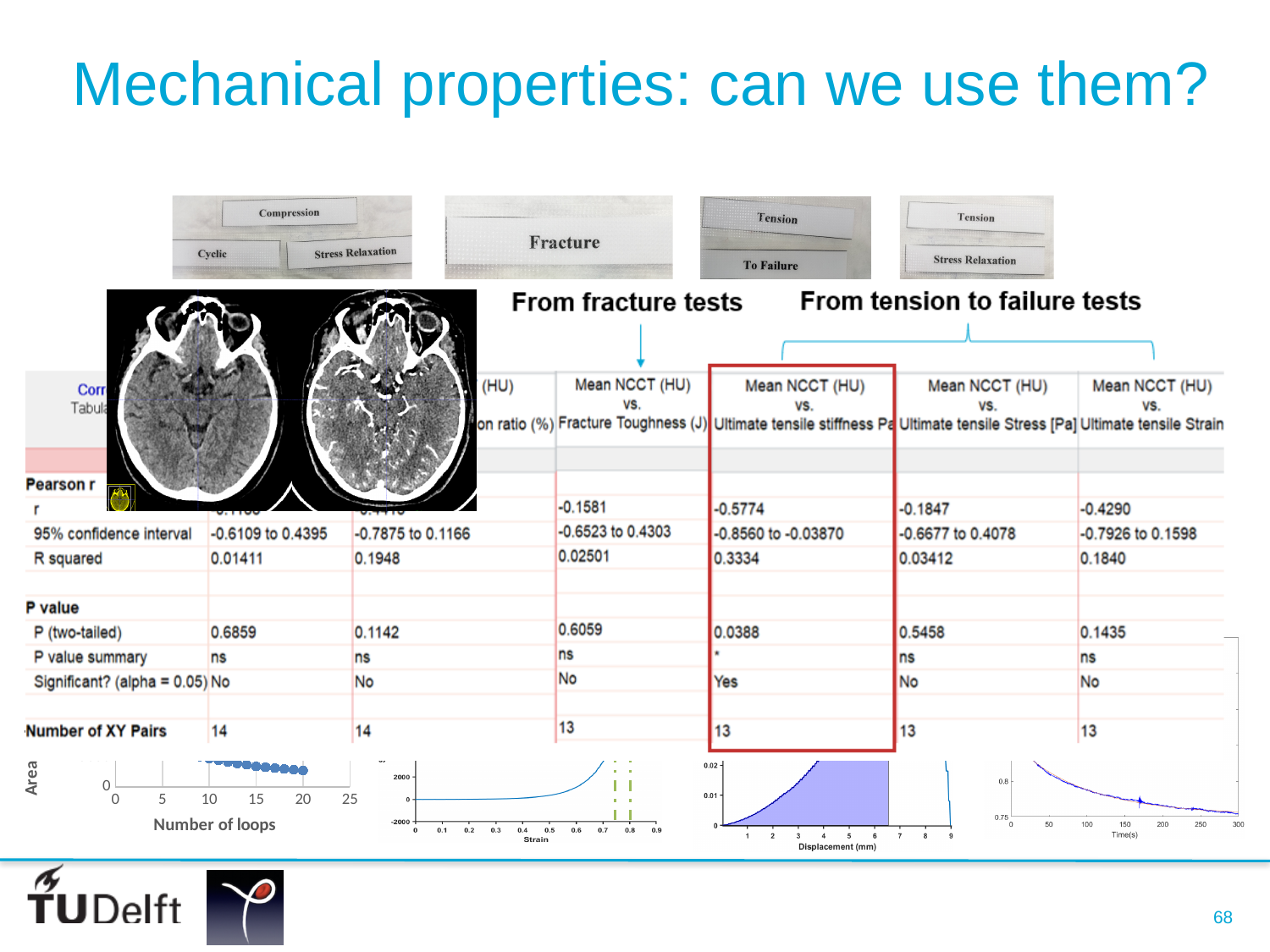
On the chart with Time(s) on the x axis, do the values rise or fall over time? fall What kind of chart is the one with Strain on the x axis? line chart On the chart with Time(s) on the x axis, is the value at time 0 greater or less than 0.8? greater On the chart with Strain on the x axis, do the values rise or fall as strain increases? rise In the correlation table, what is the Pearson r for Mean NCCT (HU) vs. Ultimate tensile stiffness? -0.5774 On the chart with Displacement (mm) on the x axis, do the values rise or fall as displacement increases from 1 to 6? rise In the correlation table, which comparison is marked as significant (alpha = 0.05)? Mean NCCT (HU) vs. Ultimate tensile stiffness In the correlation table, what is the R squared for Mean NCCT (HU) vs. Ultimate tensile Strain? 0.1840 On the chart with Time(s) on the x axis, what is the highest tick value shown on the x axis? 300 In the correlation table, what is the two-tailed P value for Mean NCCT (HU) vs. Fracture Toughness (J)? 0.6059 On the bottom-left chart, what is the label of the x axis? Number of loops On the bottom-left chart, what is the highest tick value shown on the x axis? 25